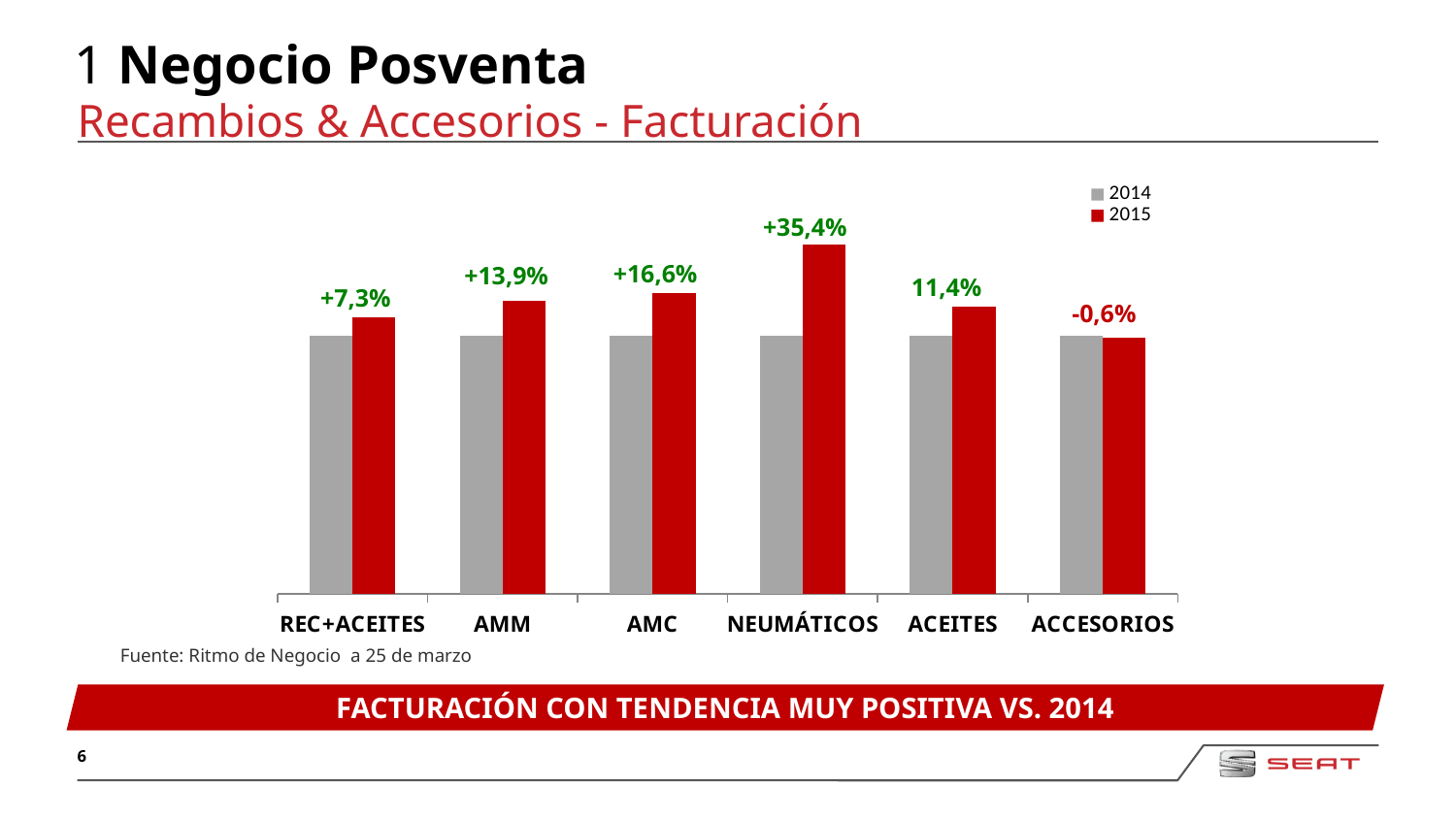
What kind of chart is shown on the slide? Bar chart Which colour represents 2015 in the legend? Red How many categories are shown on the x axis? 6 How many series does the legend list? 2 What percentage change is shown for AMM? +13,9% What percentage change is shown for AMC? +16,6% What percentage change is shown above the NEUMÁTICOS bars? +35,4% What percentage change is shown for ACCESORIOS? -0,6% Which category has the taller 2015 bar, AMM or NEUMÁTICOS? NEUMÁTICOS What percentage change is shown for REC+ACEITES? +7,3% Which category shows the lowest percentage change? ACCESORIOS Which category shows the largest percentage increase? NEUMÁTICOS